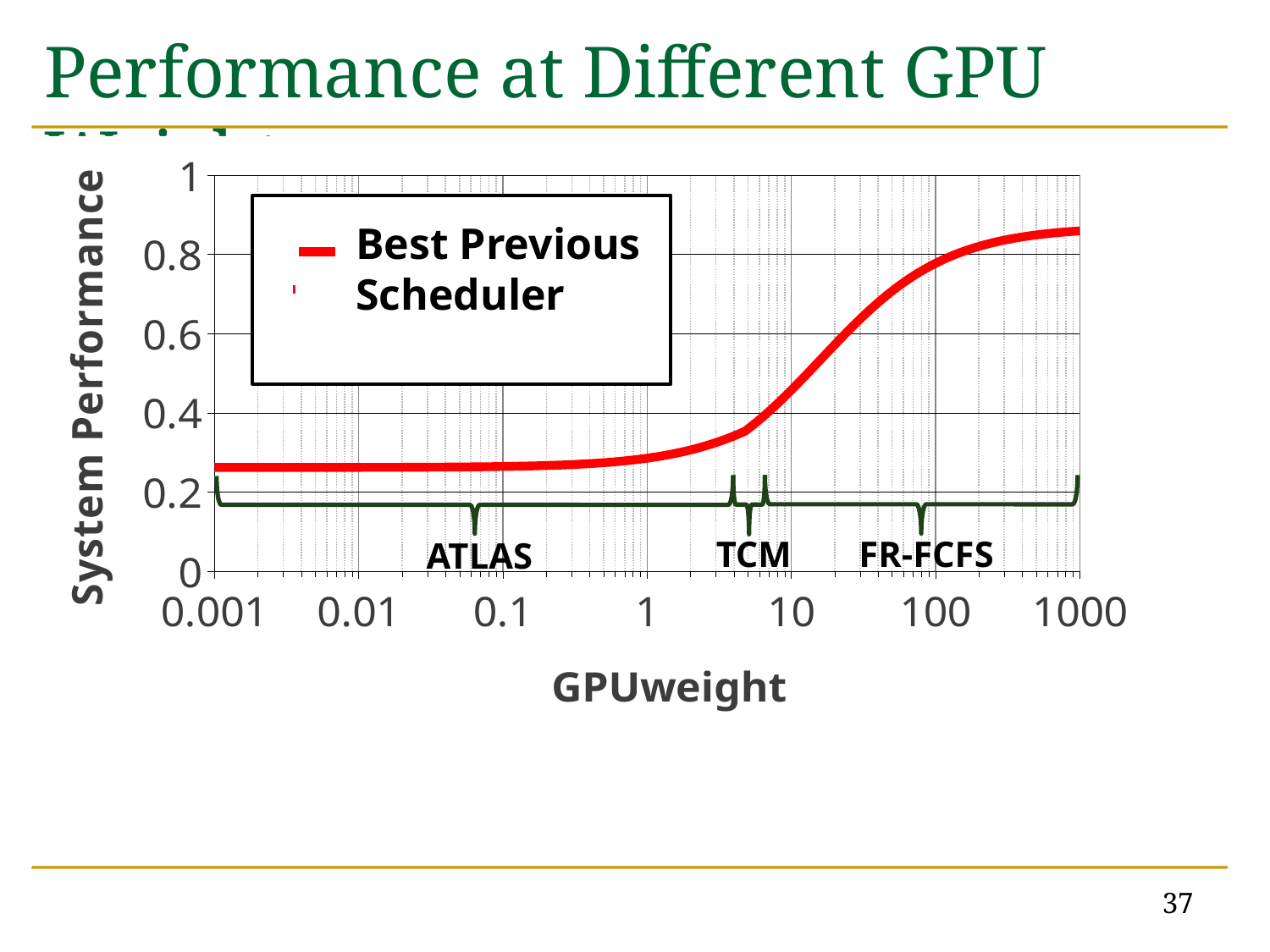
What is the name of the series shown in the legend? Best Previous Scheduler Is the System Performance value at GPUweight 10 greater or less than 0.4? greater Is the System Performance value at GPUweight 0.001 greater or less than 0.4? less Is the System Performance value at GPUweight 0.1 greater or less than 0.6? less Which is larger, the System Performance at GPUweight 1000 or at GPUweight 0.01? GPUweight 1000 Does System Performance rise or fall as GPUweight increases along the x axis? rise What kind of chart is shown on the slide? line chart What is the title of the x axis? GPUweight How many series does the legend list? 1